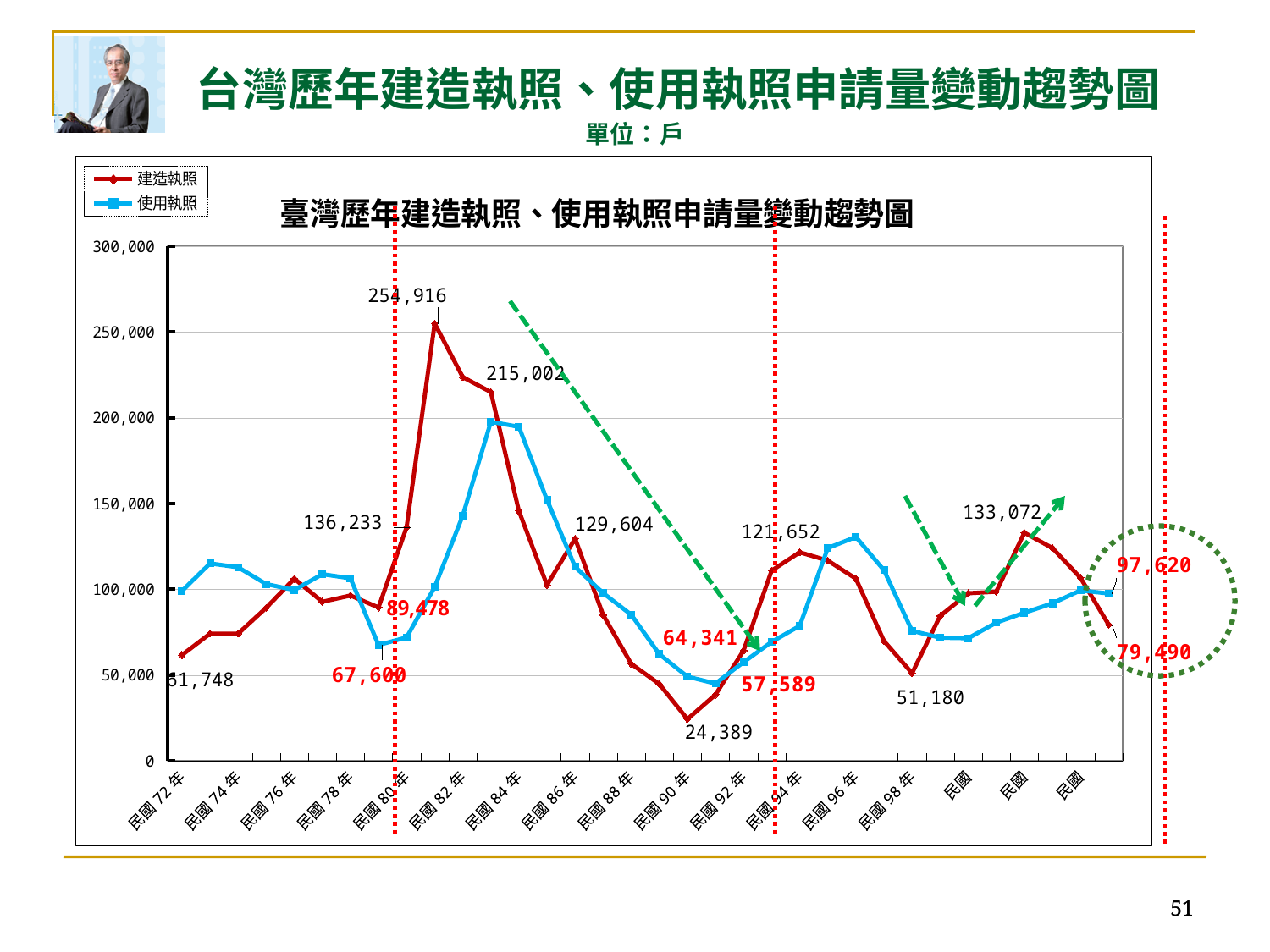
What type of chart is shown on the slide? line chart At the right end of the chart, which series has the higher value, 建造執照 or 使用執照? 使用執照 What is the final labelled value of the 建造執照 series at the right end of the chart? 79,490 What unit is stated for the values in the chart? 戶 At the right end of the chart, what is the difference between the 使用執照 value (97,620) and the 建造執照 value (79,490)? 18,130 How many series does the chart legend list? 2 What are the two series named in the chart legend? 建造執照 and 使用執照 What is the final labelled value of the 使用執照 series at the right end of the chart? 97,620 Is the value for 使用執照 at 民國84年 greater or less than 150,000? greater What is the lowest value reached by the 建造執照 series? 24,389 What is the highest value reached by the 建造執照 series? 254,916 At 民國82年, which series is higher, 建造執照 or 使用執照? 建造執照